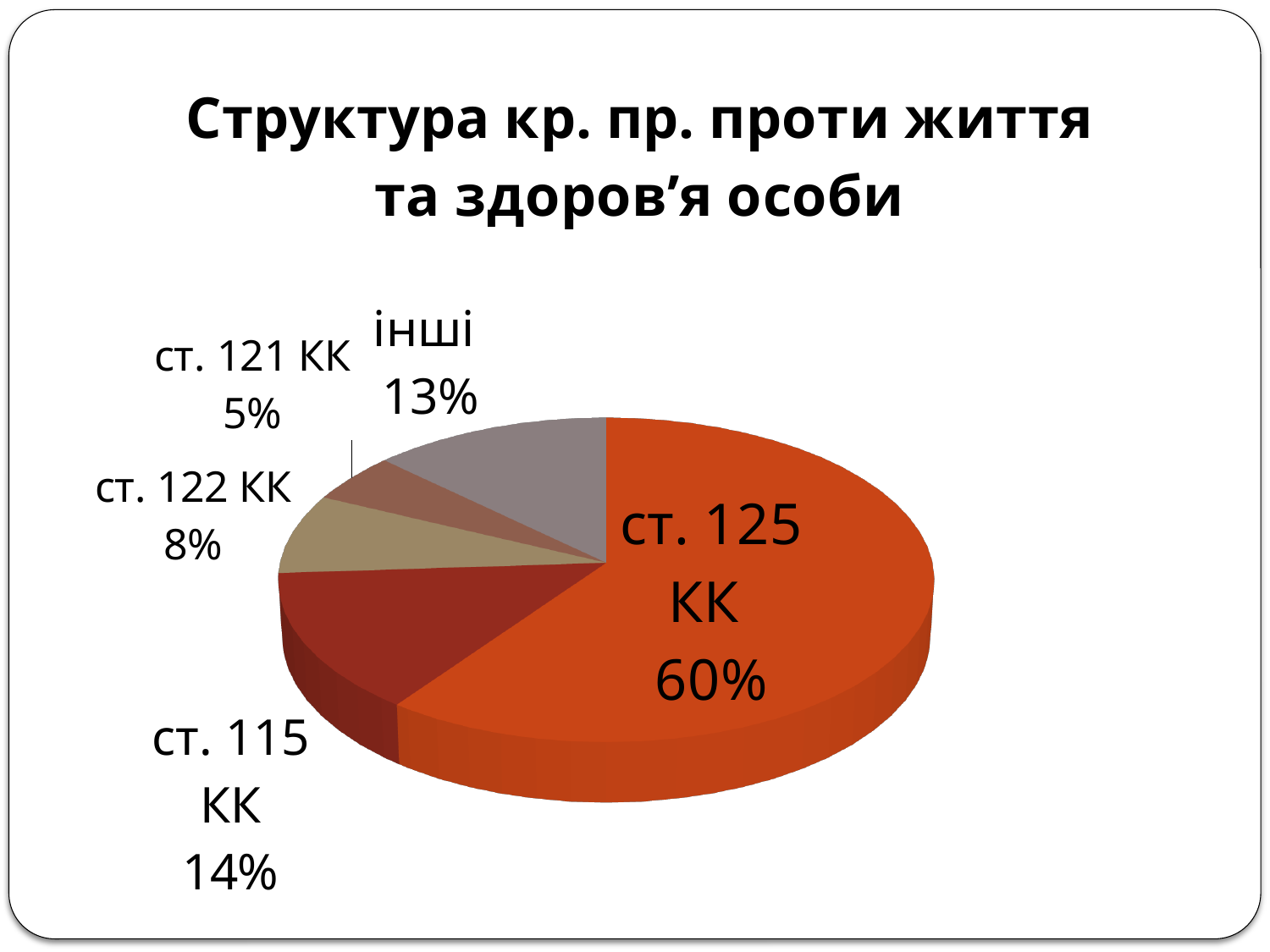
What share of the pie does ст. 115 КК have? 14% How many slices does the pie chart have? 5 What is the title of the chart? Структура кр. пр. проти життя та здоров’я особи What share of the pie does the інші slice have? 13% What kind of chart is shown on the slide? pie chart Which slice is the smallest? ст. 121 КК What share of the pie does ст. 121 КК have? 5% Which slice is the largest? ст. 125 КК Which is larger, the share for ст. 115 КК or the share for інші? ст. 115 КК What is the difference in percentage points between ст. 125 КК and ст. 115 КК? 46